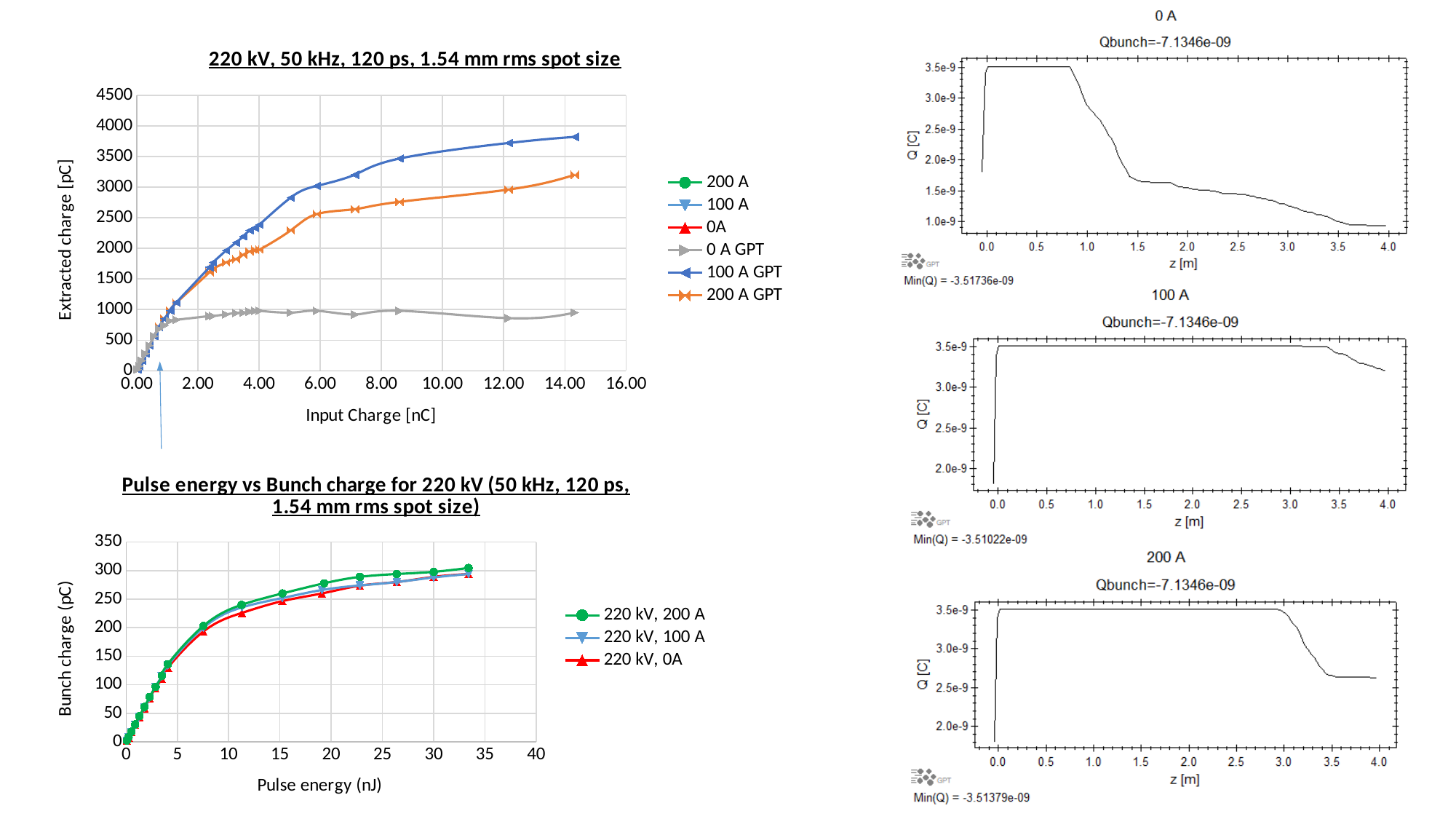
In the right-hand chart titled "100 A", what is the printed Min(Q) value? -3.51022e-09 What kind of chart is the top-left chart titled "220 kV, 50 kHz, 120 ps, 1.54 mm rms spot size"? line chart In the top-left chart ("220 kV, 50 kHz, 120 ps, 1.54 mm rms spot size"), is the extracted charge for the 100 A GPT series at its highest input charge greater or less than 3500 pC? greater How many series does the legend of the top-left chart ("220 kV, 50 kHz, 120 ps, 1.54 mm rms spot size") list? 6 How many series does the legend of the bottom-left chart ("Pulse energy vs Bunch charge for 220 kV") list? 3 In the bottom-left chart ("Pulse energy vs Bunch charge for 220 kV"), does the bunch charge rise or fall as pulse energy increases? rise In the top-left chart ("220 kV, 50 kHz, 120 ps, 1.54 mm rms spot size"), which series reaches the highest extracted charge at the largest input charge? 100 A GPT In the bottom-left chart ("Pulse energy vs Bunch charge for 220 kV"), is the bunch charge for the 220 kV, 200 A series at about 33 nJ greater or less than 250 pC? greater What is the x-axis label of the top-left chart ("220 kV, 50 kHz, 120 ps, 1.54 mm rms spot size")? Input Charge [nC] In the right-hand chart titled "200 A", what is the printed Qbunch value? -7.1346e-09 In the top-left chart ("220 kV, 50 kHz, 120 ps, 1.54 mm rms spot size"), which series has the lowest extracted charge at 12 nC input charge? 0 A GPT